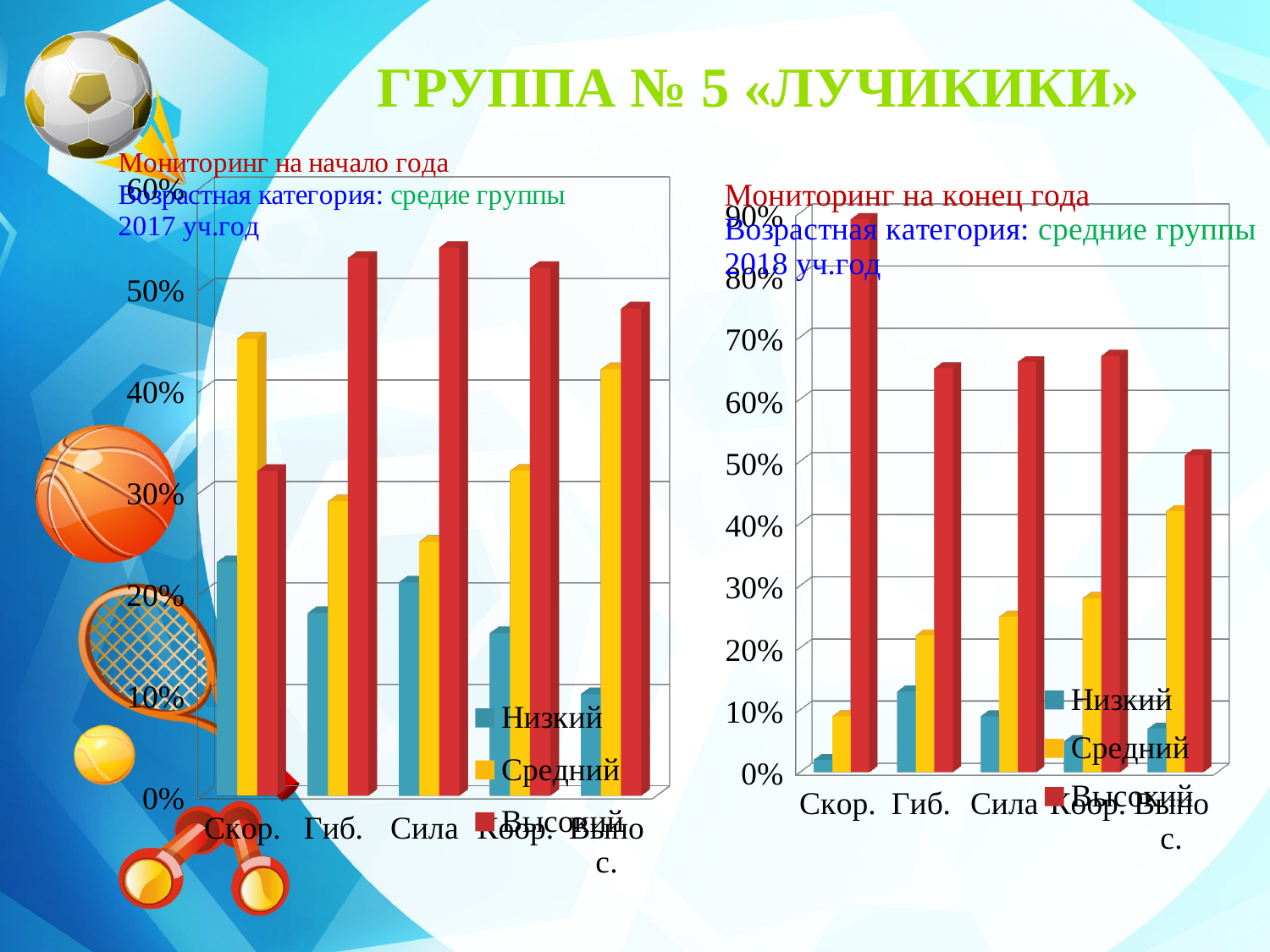
On the chart titled «Мониторинг на конец года», is the value of Высокий for Скор. greater or less than 80%? greater What kind of chart is the chart titled «Мониторинг на начало года»? bar chart On the chart titled «Мониторинг на конец года», which category has the highest value for the series Высокий? Скор. On the chart titled «Мониторинг на конец года», which is larger for Гиб.: Высокий or Средний? Высокий What are the three legend entries on the chart titled «Мониторинг на конец года»? Низкий, Средний, Высокий On the chart titled «Мониторинг на начало года», is the value of Высокий for Скор. greater or less than 40%? less How many series does the legend list on the chart titled «Мониторинг на начало года»? 3 On the chart titled «Мониторинг на начало года», which category has the lowest value for the series Высокий? Скор. How many categories are shown on the x axis of the chart titled «Мониторинг на конец года»? 5 On the chart titled «Мониторинг на начало года», which is larger for Скор.: Средний or Высокий? Средний On the chart titled «Мониторинг на конец года», is the value of Низкий for Скор. greater or less than 10%? less On the chart titled «Мониторинг на начало года», which category has the highest value for the series Средний? Скор.